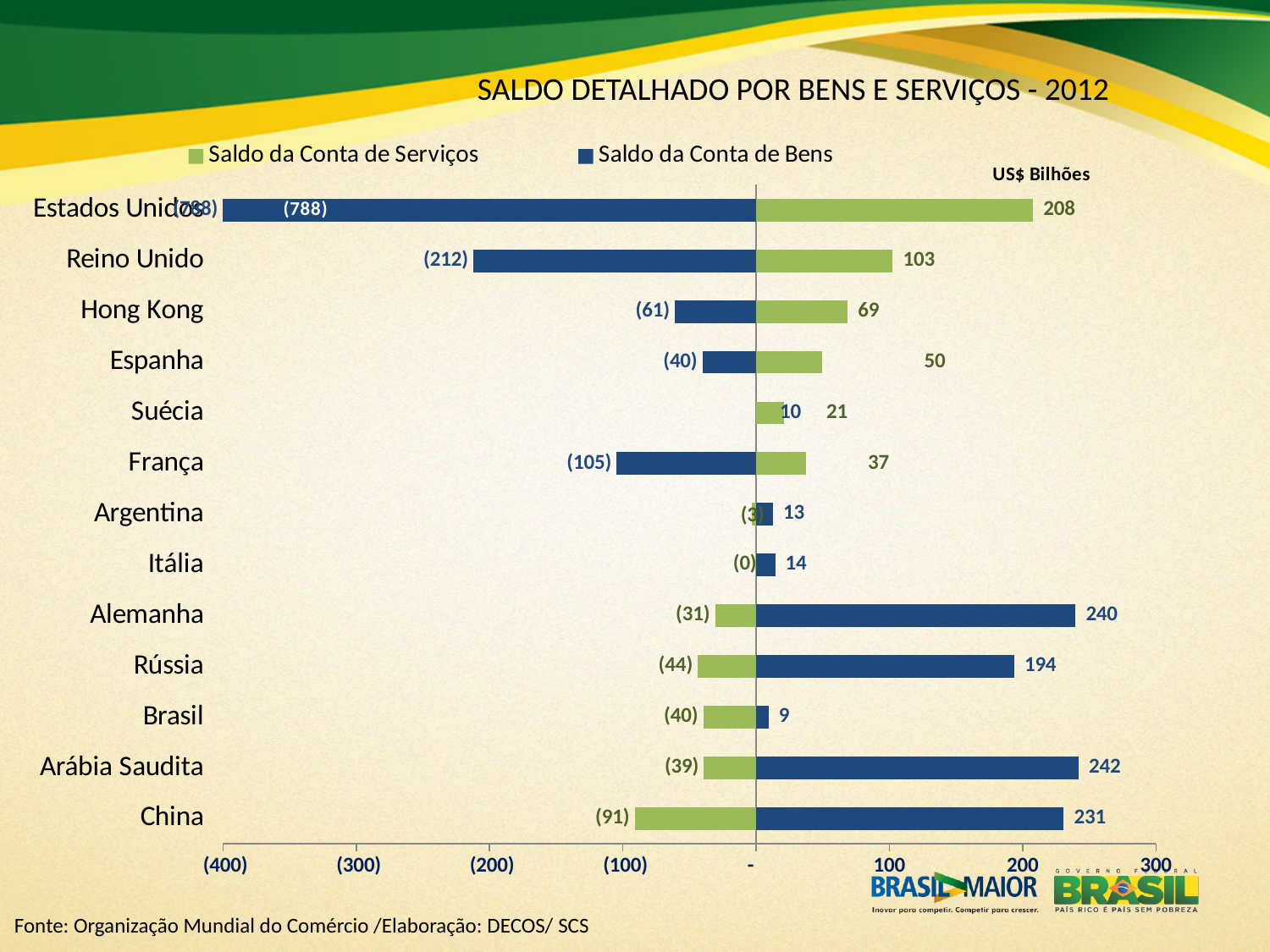
Which is larger, the Saldo da Conta de Serviços for Reino Unido or for Hong Kong? Reino Unido Which country has the highest Saldo da Conta de Serviços? Estados Unidos Which country has the lowest Saldo da Conta de Bens? Estados Unidos What unit is indicated for the values on the chart? US$ Bilhões What is the Saldo da Conta de Bens value for China? 231 How many countries are shown on the chart? 13 What is the Saldo da Conta de Bens value for Estados Unidos? (788) What kind of chart is shown on the slide? Bar chart What is the Saldo da Conta de Serviços value for Brasil? (40) What is the difference between the Saldo da Conta de Bens values for China and Rússia? 37 What is the Saldo da Conta de Serviços value for Reino Unido? 103 How many series does the legend list? 2